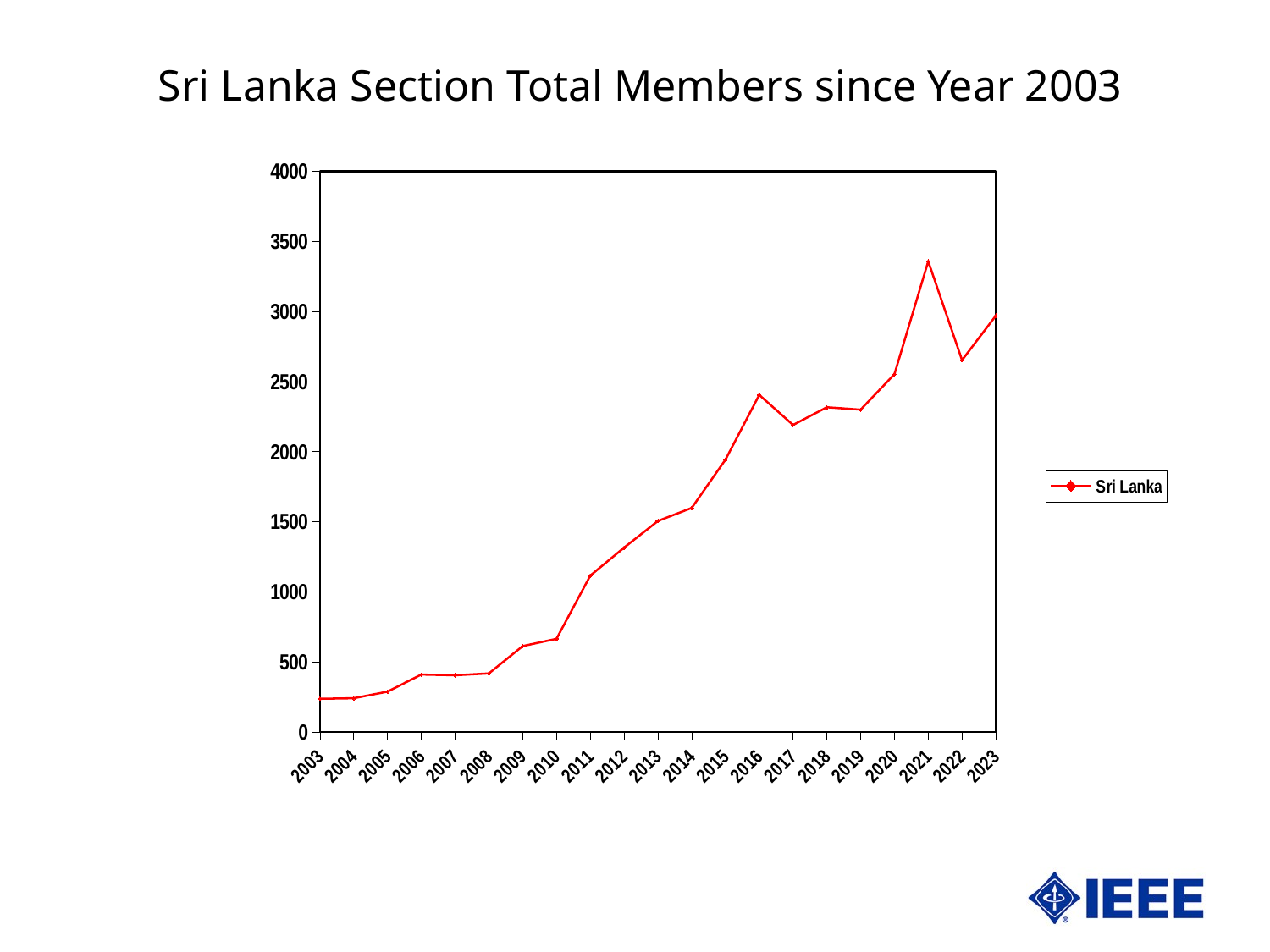
What is the title of the chart? Sri Lanka Section Total Members since Year 2003 How many series does the legend list? 1 What is the name of the series shown in the legend? Sri Lanka Which year has the larger value, 2016 or 2017? 2016 Is the value for 2016 greater or less than 2500? less Is the value for 2011 greater or less than 1000? greater Overall, do the values rise or fall from 2003 to 2023? rise Is the value for 2003 greater or less than 500? less In which year is the number of members highest? 2021 How many years are plotted along the x axis? 21 What kind of chart is shown on the slide? line chart